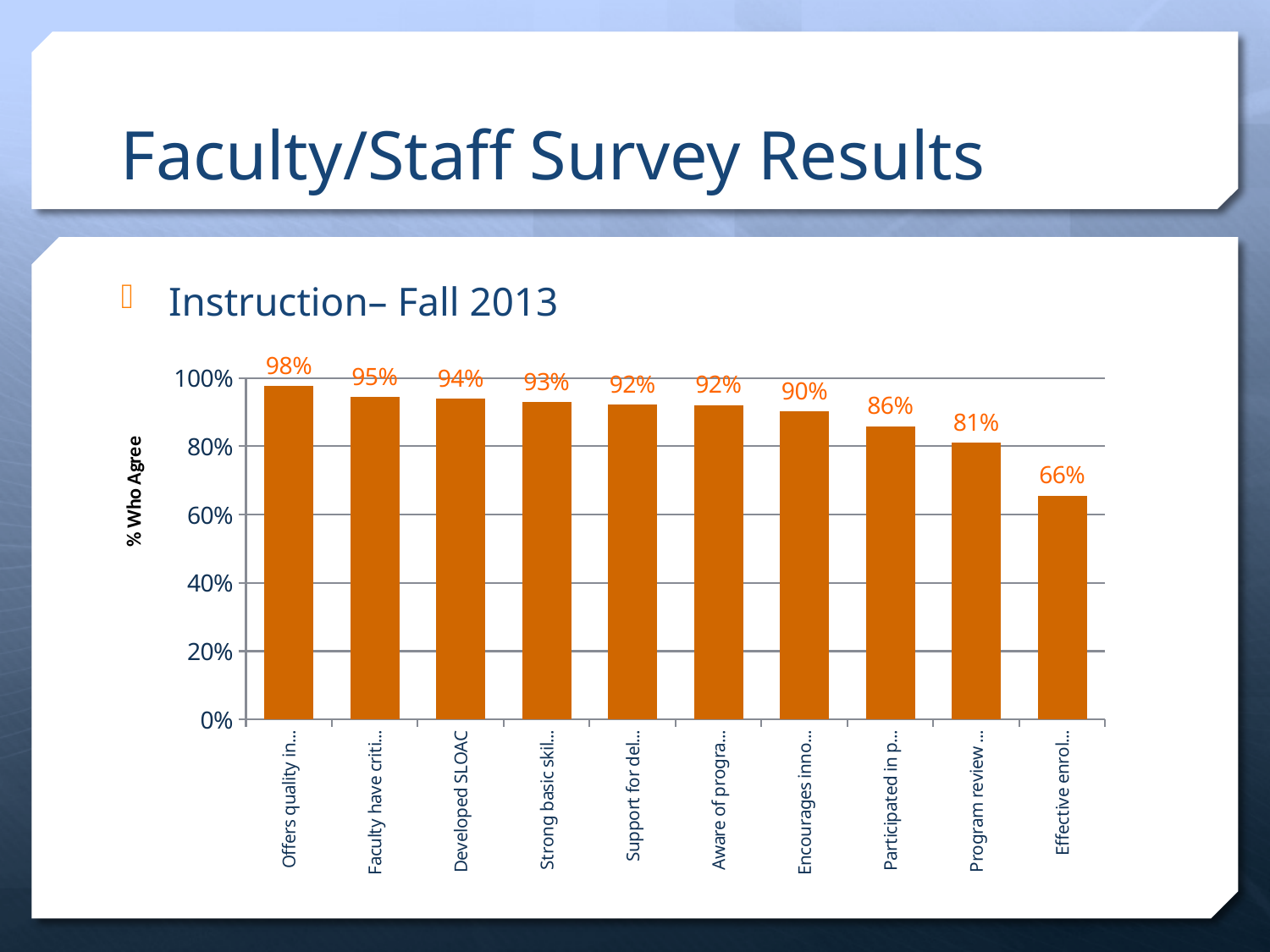
What is the difference between the highest bar (98%) and the lowest bar (66%)? 32% Which is larger, the value for "Faculty have criti..." or the value for "Encourages inno..."? Faculty have criti... What is the label of the vertical axis? % Who Agree Do the values rise or fall moving from left to right along the x axis? fall What is the difference between the values for "Strong basic skil..." and "Program review ..."? 12% Which category has the lowest value? Effective enrol... What is the value for the bar labelled "Developed SLOAC"? 94% What is the value for the bar labelled "Program review ..."? 81% How many bars are plotted in the chart? 10 What kind of chart is shown on the slide? bar chart Which category has the highest value? Offers quality in... What is the value for the bar labelled "Participated in p..."? 86%